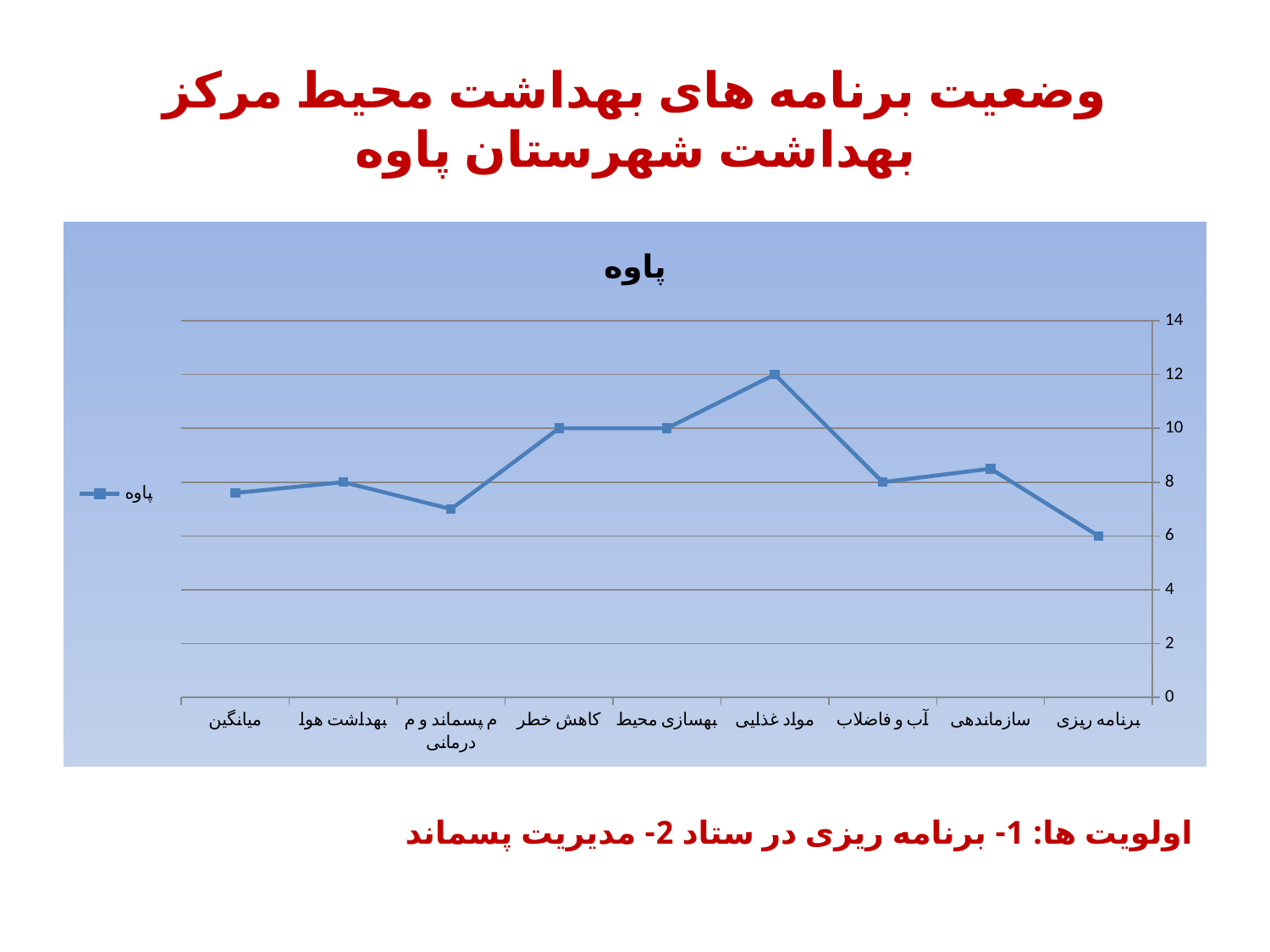
What is the value for برنامه ریزی? 6 What is the value for مولد غذایی? 12 What is the difference between the values for مولد غذایی and برنامه ریزی? 6 Which category has the highest value? مولد غذایی What is the value for آب و فاضلاب? 8 Which category has the lowest value? برنامه ریزی Which is larger, the value for بهسازی محیط or the value for آب و فاضلاب? بهسازی محیط What is the value for کاهش خطر? 10 Is the value for م پسماند و م درمانی greater or less than 8? less How many categories are shown on the x axis? 9 What kind of chart is shown? line chart How many series does the legend list? 1